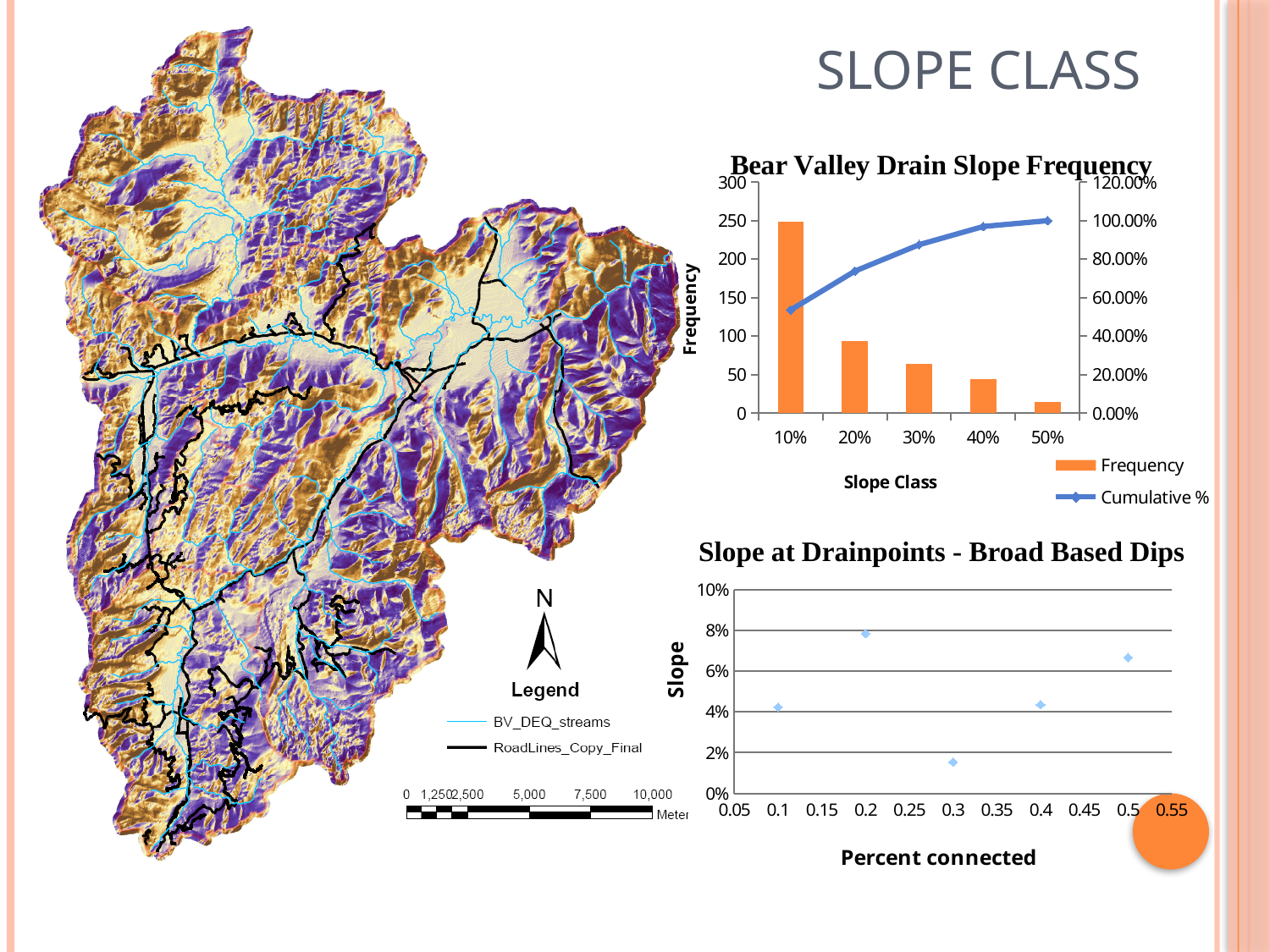
In the Bear Valley Drain Slope Frequency chart, how many series does the legend list? 2 In the Slope at Drainpoints - Broad Based Dips chart, at which Percent connected value is the slope highest? 0.2 In the Slope at Drainpoints - Broad Based Dips chart, at which Percent connected value is the slope lowest? 0.3 In the Bear Valley Drain Slope Frequency chart, how many slope classes are shown on the x axis? 5 In the Bear Valley Drain Slope Frequency chart, which slope class has the highest frequency? 10% In the Bear Valley Drain Slope Frequency chart, does the Cumulative % line rise or fall as the slope class increases? rises In the Bear Valley Drain Slope Frequency chart, is the frequency for the 20% slope class greater or less than 100? less In the Bear Valley Drain Slope Frequency chart, is the frequency for the 10% slope class greater or less than 200? greater In the Slope at Drainpoints - Broad Based Dips chart, is the slope at Percent connected 0.3 greater or less than 2%? less In the Bear Valley Drain Slope Frequency chart, which slope class has the lowest frequency? 50% In the Slope at Drainpoints - Broad Based Dips chart, how many data points are plotted? 5